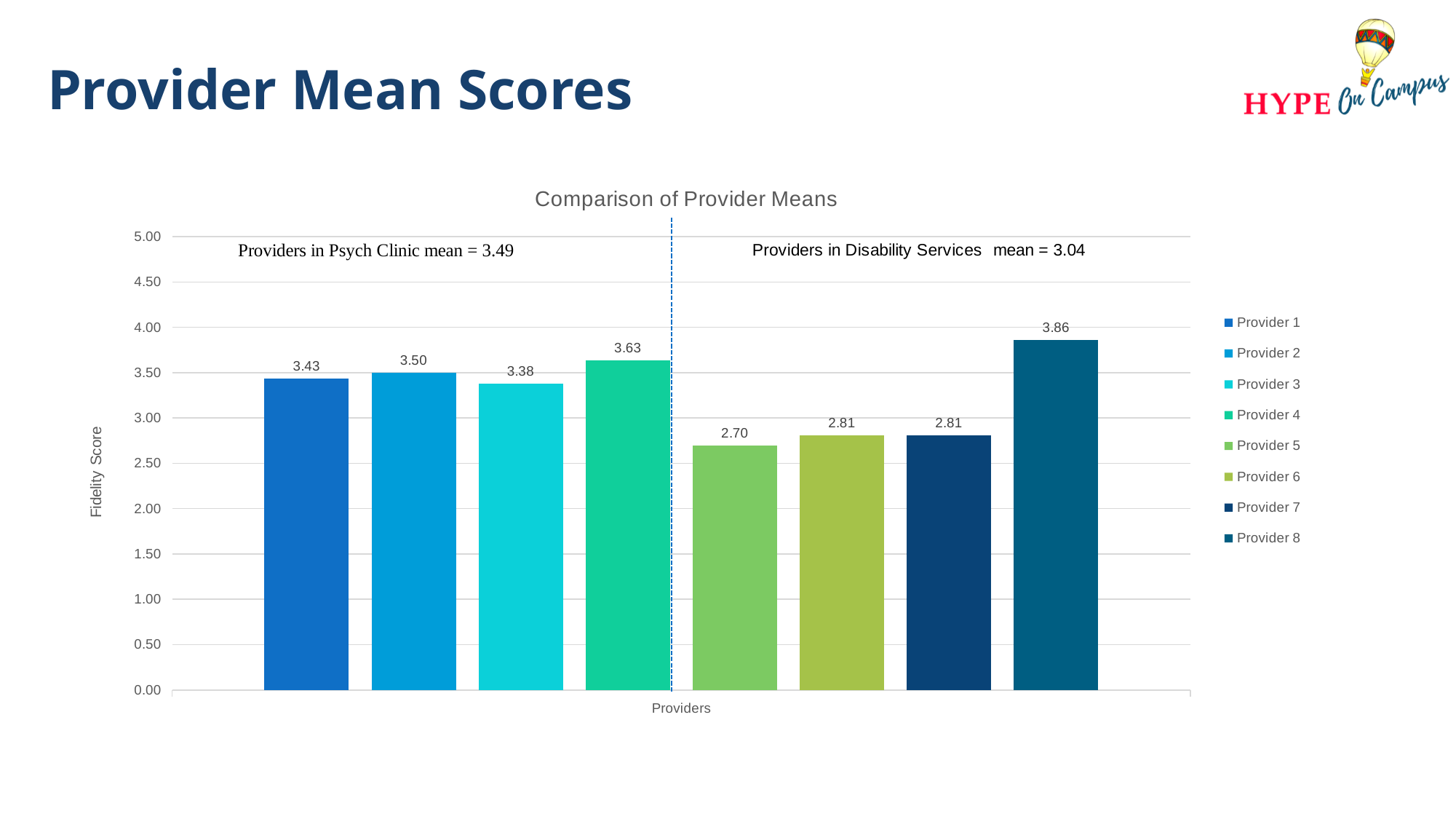
Which provider has the lowest fidelity score? Provider 5 What is the fidelity score for Provider 8? 3.86 What is the fidelity score for Provider 1? 3.43 Which has a higher fidelity score, Provider 2 or Provider 6? Provider 2 Which provider has the highest fidelity score? Provider 8 What is the fidelity score for Provider 5? 2.70 How many providers are shown in the chart? 8 What is the difference between the fidelity scores of Provider 4 and Provider 3? 0.25 What is the title of the chart? Comparison of Provider Means What type of chart is shown on the slide? Bar chart What is the difference between the fidelity scores of Provider 8 and Provider 5? 1.16 Is the value for Provider 7 greater or less than 3.00? less